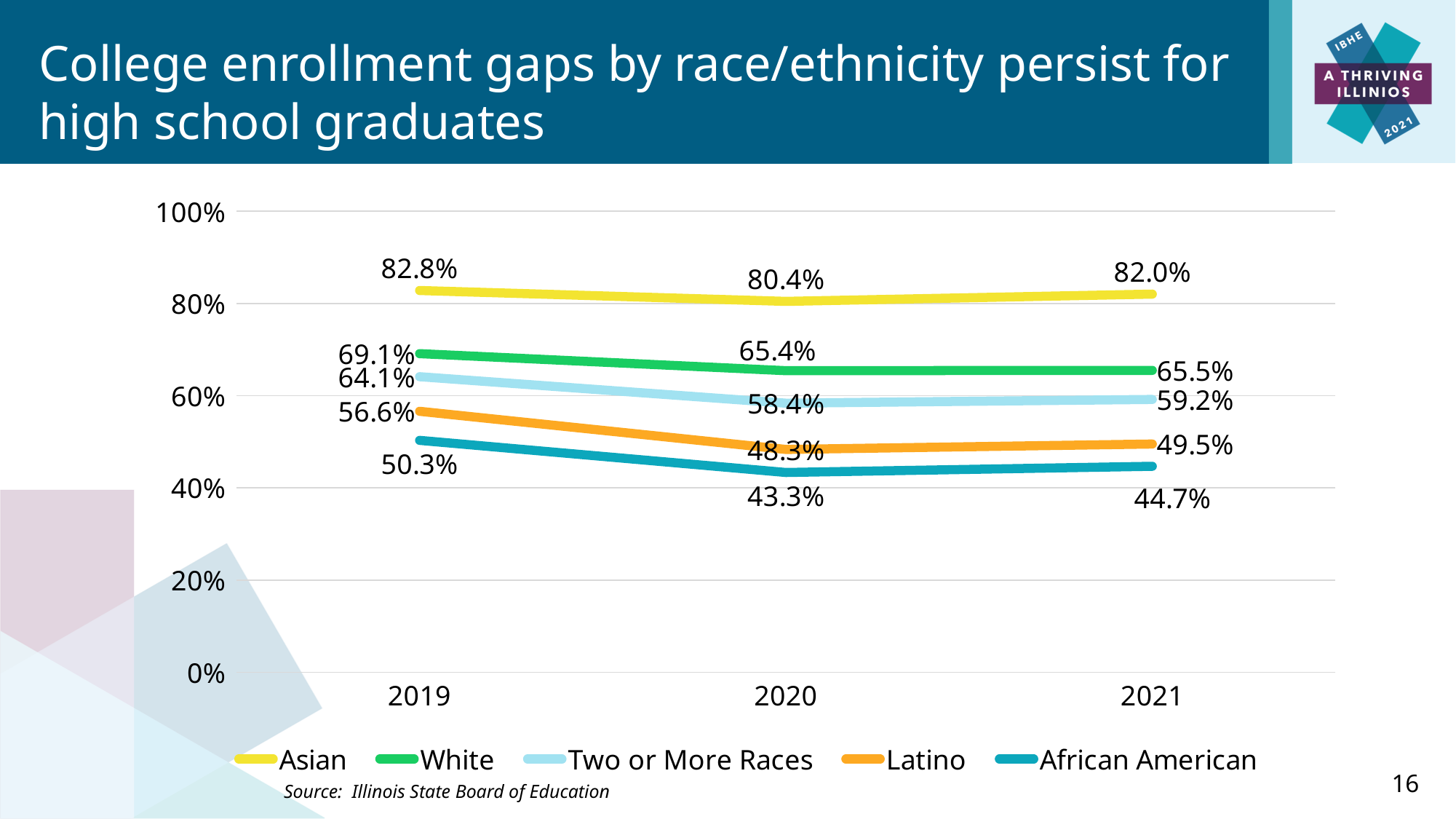
Which was higher in 2020: the White enrollment rate or the Two or More Races enrollment rate? White Did the Latino enrollment rate rise or fall from 2019 to 2020? Fall Which group had the highest college enrollment rate in 2021? Asian What was the college enrollment rate for Two or More Races in 2020? 58.4% What was the college enrollment rate for African American high school graduates in 2020? 43.3% How many series does the legend list? 5 What was the college enrollment rate for Asian high school graduates in 2019? 82.8% What is the difference between the Asian and African American enrollment rates in 2021? 37.3% Which group had the lowest college enrollment rate in 2019? African American What kind of chart is shown on the slide? Line chart What was the college enrollment rate for Latino high school graduates in 2021? 49.5% How many years are shown on the x axis? 3